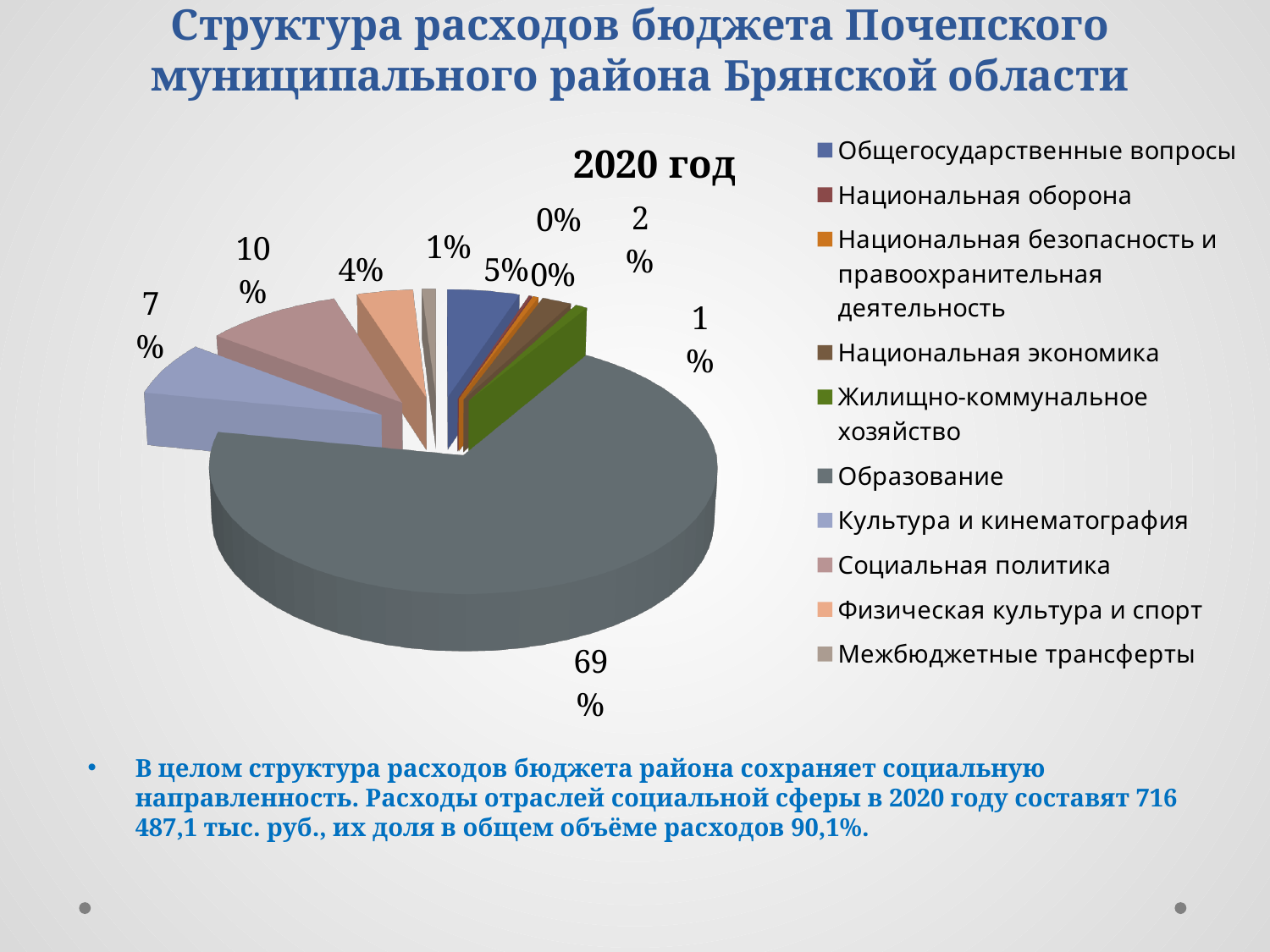
Which is larger: the share for Социальная политика or the share for Культура и кинематография? Социальная политика What share of the pie does Культура и кинематография have? 7% What share of the pie does Социальная политика have? 10% What is the difference in percentage points between the share for Образование and the share for Социальная политика? 59 What share of the pie does Физическая культура и спорт have? 4% What is the difference in percentage points between the share for Социальная политика and the share for Культура и кинематография? 3 Which category has the largest share of the pie? Образование What kind of chart is shown on the slide? pie chart What is the title of the chart? 2020 год How many categories does the chart's legend list? 10